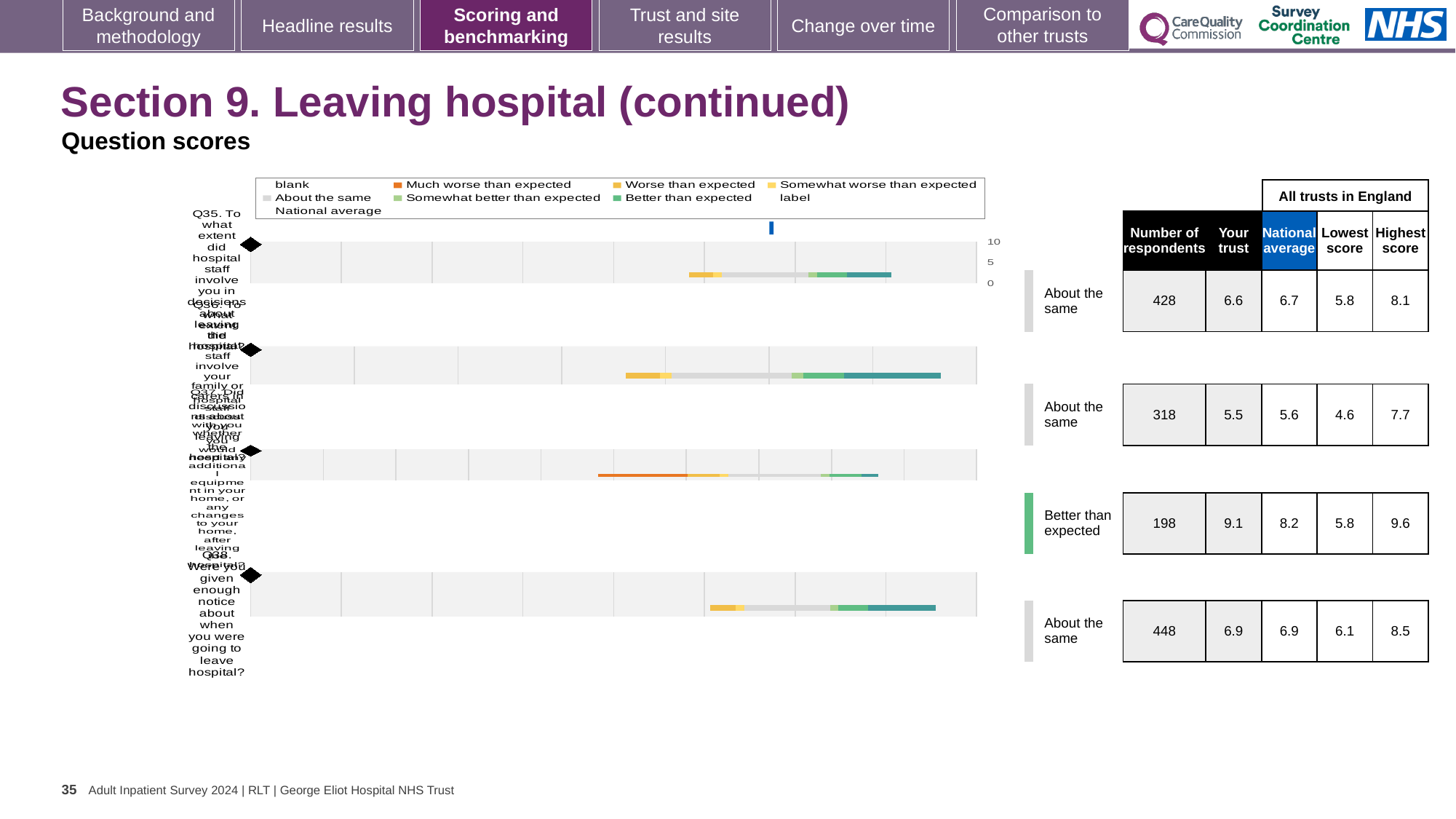
What kind of chart is shown on the slide? bar chart What colour is the 'Much worse than expected' band in the chart legend? orange In the table next to the chart, what is the number of respondents for Q38? 448 In the table next to the chart, what is the national average for Q36? 5.6 Which benchmark category is shown for Q37 in the chart? Better than expected In the table next to the chart, what is the difference between the highest score and the lowest score for Q35? 2.3 In the table next to the chart, which question has the lowest number of respondents? Q37 In the table next to the chart, what is the 'Your trust' score for Q37? 9.1 How many entries does the chart legend list? 9 How many questions (bars) are plotted in the chart? 4 In the table next to the chart, which question has the highest 'Your trust' score? Q37 In the table next to the chart, is the 'Your trust' score for Q36 larger or smaller than the national average for Q36? smaller